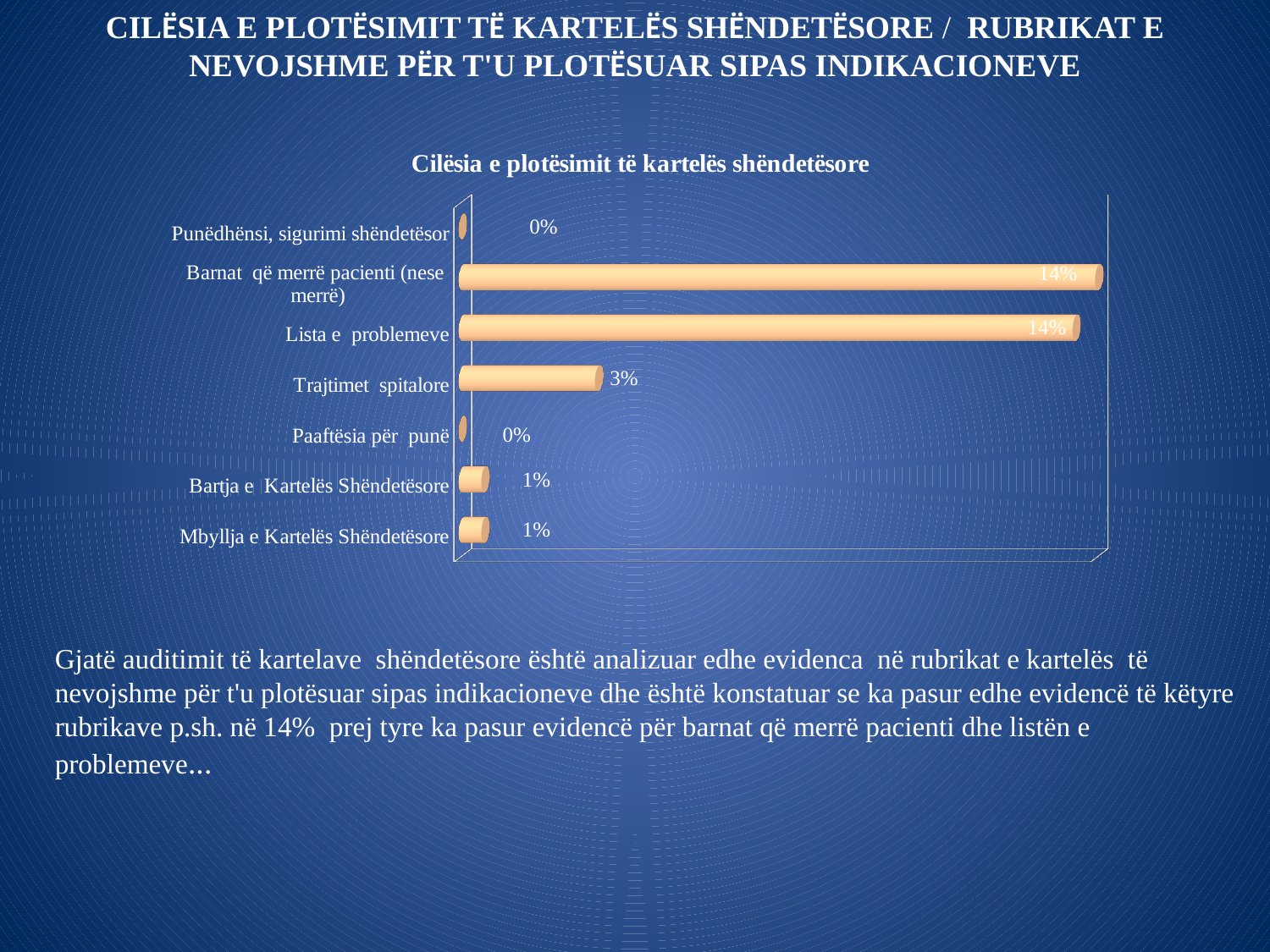
What is the value for Lista e problemeve? 14% What is the value for Mbyllja e Kartelës Shëndetësore? 1% What is the title of the chart? Cilësia e plotësimit të kartelës shëndetësore What is the value for Trajtimet spitalore? 3% What is the difference between the value for Lista e problemeve and the value for Trajtimet spitalore? 11% What is the value for Bartja e Kartelës Shëndetësore? 1% What kind of chart is shown on the slide? Bar chart Which is larger, the value for Trajtimet spitalore or the value for Bartja e Kartelës Shëndetësore? Trajtimet spitalore How many categories are shown in the chart? 7 What is the value for Barnat që merrë pacienti (nese merrë)? 14% What is the value for Punëdhënsi, sigurimi shëndetësor? 0% What is the value for Paaftësia për punë? 0%